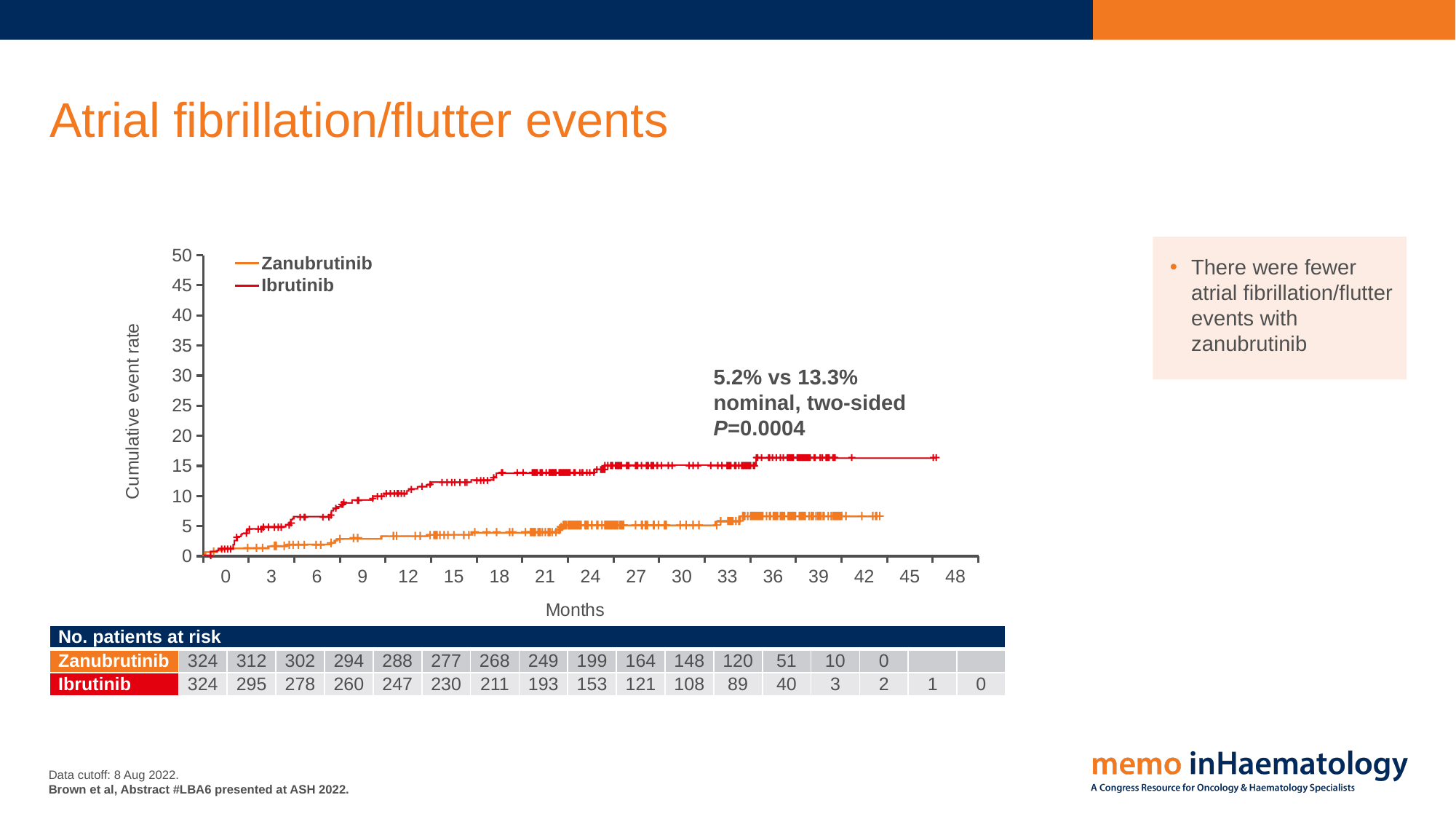
Which series has the higher cumulative event rate at 36 months, Zanubrutinib or Ibrutinib? Ibrutinib Is the cumulative event rate for Zanubrutinib at 24 months greater or less than 10? less What is the label of the y axis? Cumulative event rate Do the cumulative event rate curves rise or fall as months increase? rise How many Zanubrutinib patients were at risk at month 0 according to the table? 324 What kind of chart is shown on the slide? line chart What event rates are compared in the annotation on the chart? 5.2% vs 13.3% Which two treatments are listed in the chart legend? Zanubrutinib and Ibrutinib How many series does the chart legend list? 2 How many Ibrutinib patients were at risk at month 24 according to the table? 153 What P value is shown on the chart? P=0.0004 Is the cumulative event rate for Ibrutinib at 24 months greater or less than 10? greater